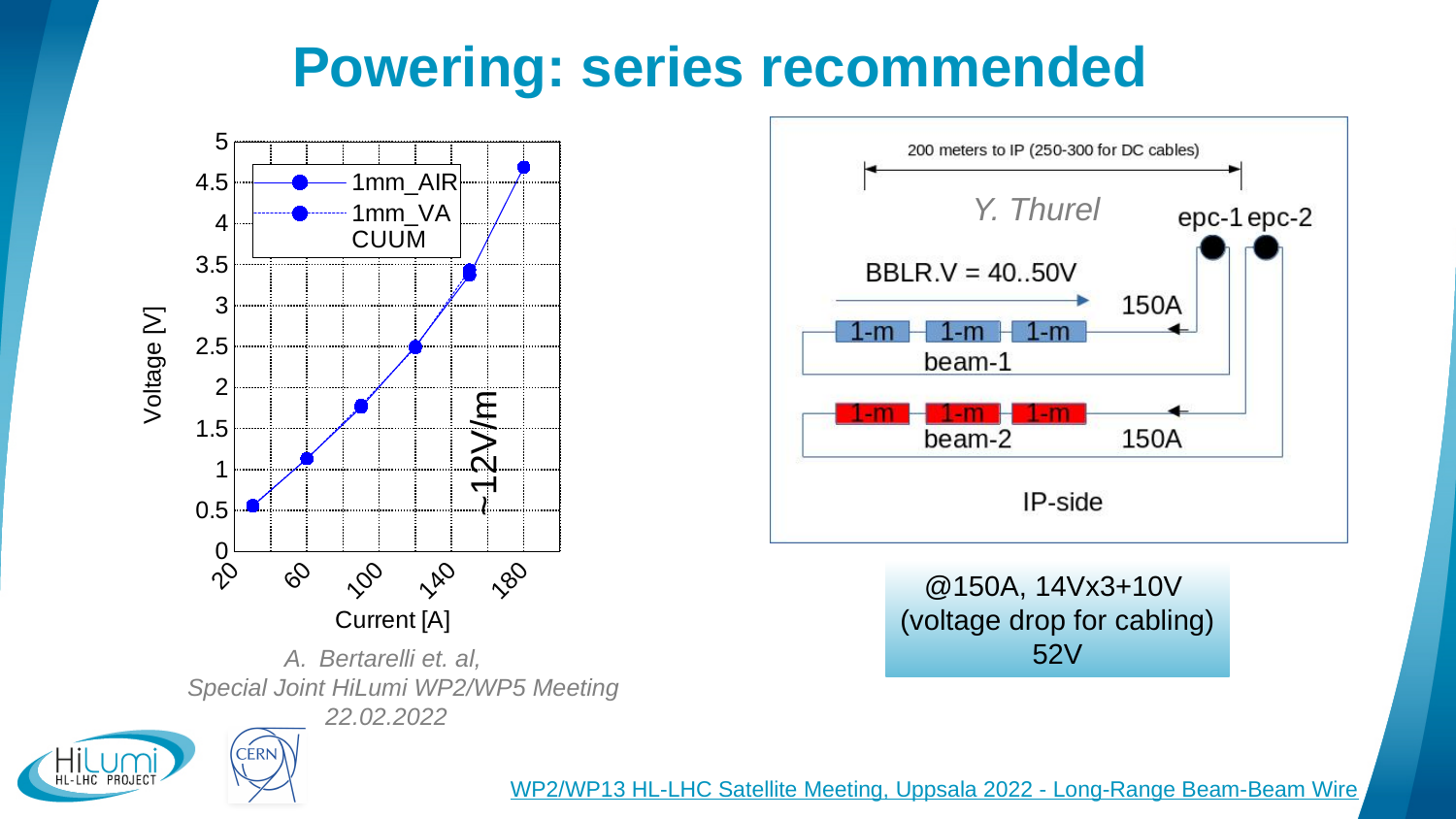
Is the voltage at 180 A greater or less than 4 V? greater What are the two series named in the chart legend? 1mm_AIR and 1mm_VACUUM Is the voltage at the lowest plotted current (about 30 A) greater or less than 1 V? less Is the voltage at 150 A greater or less than 3 V? greater Does the voltage rise or fall as the current increases along the x axis? rises What is the label of the chart's y axis? Voltage [V] How many series does the chart legend list? 2 What kind of chart is shown on the slide? line chart